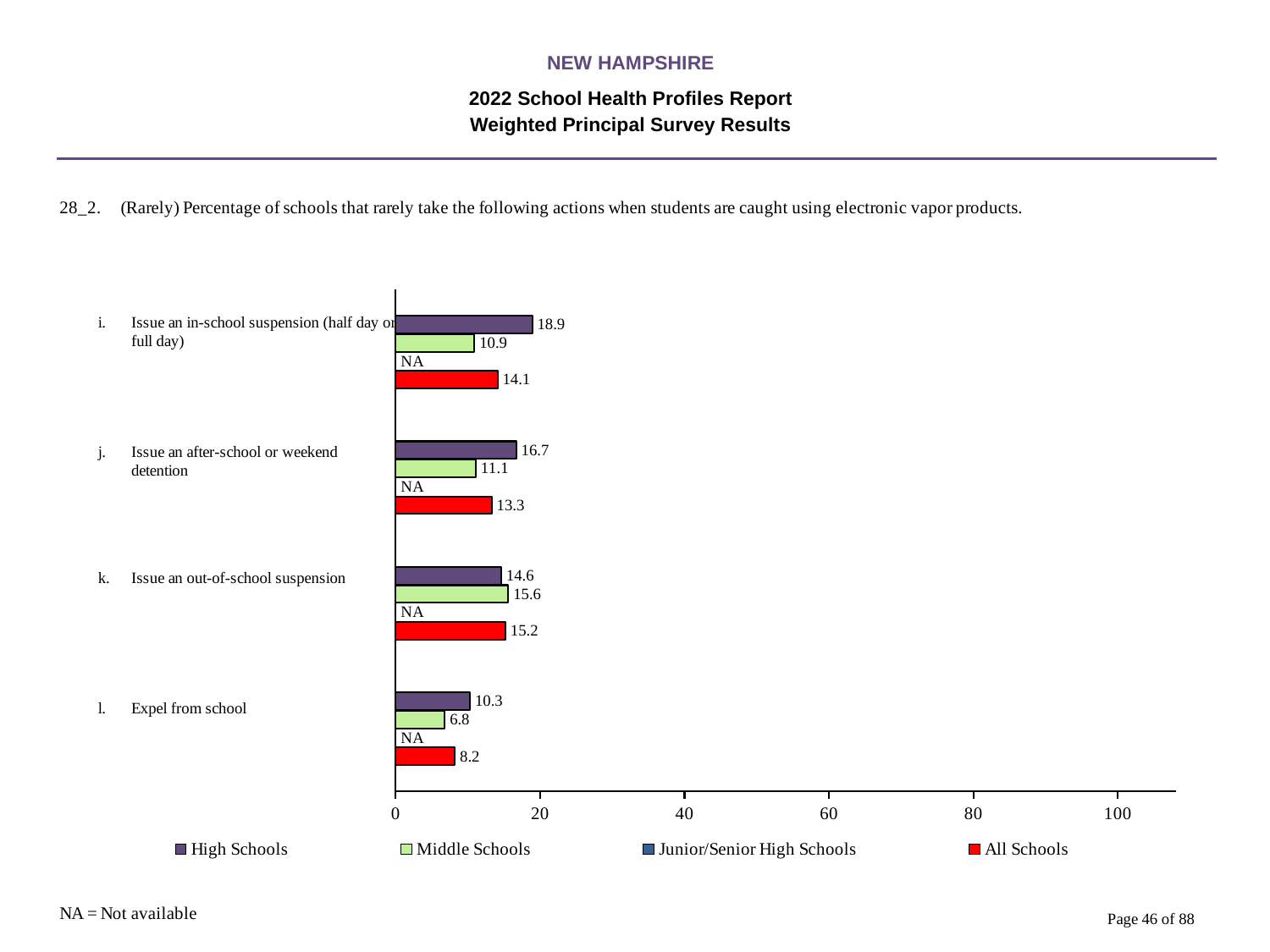
What is the value for High Schools for 'Issue an in-school suspension (half day or full day)'? 18.9 Is the All Schools value for 'Issue an after-school or weekend detention' greater or less than 20? less Which action has the highest value for High Schools? Issue an in-school suspension (half day or full day) What is the value for All Schools for 'Issue an out-of-school suspension'? 15.2 What is the value for Middle Schools for 'Expel from school'? 6.8 What is the difference between the High Schools and Middle Schools values for 'Issue an in-school suspension (half day or full day)'? 8.0 Which action has the lowest value for All Schools? Expel from school What kind of chart is shown on the slide? bar chart How many actions (categories) are shown on the chart? 4 What value is shown for Junior/Senior High Schools for 'Issue an after-school or weekend detention'? NA For 'Issue an out-of-school suspension', which is larger: the High Schools value or the Middle Schools value? Middle Schools How many series does the legend list? 4